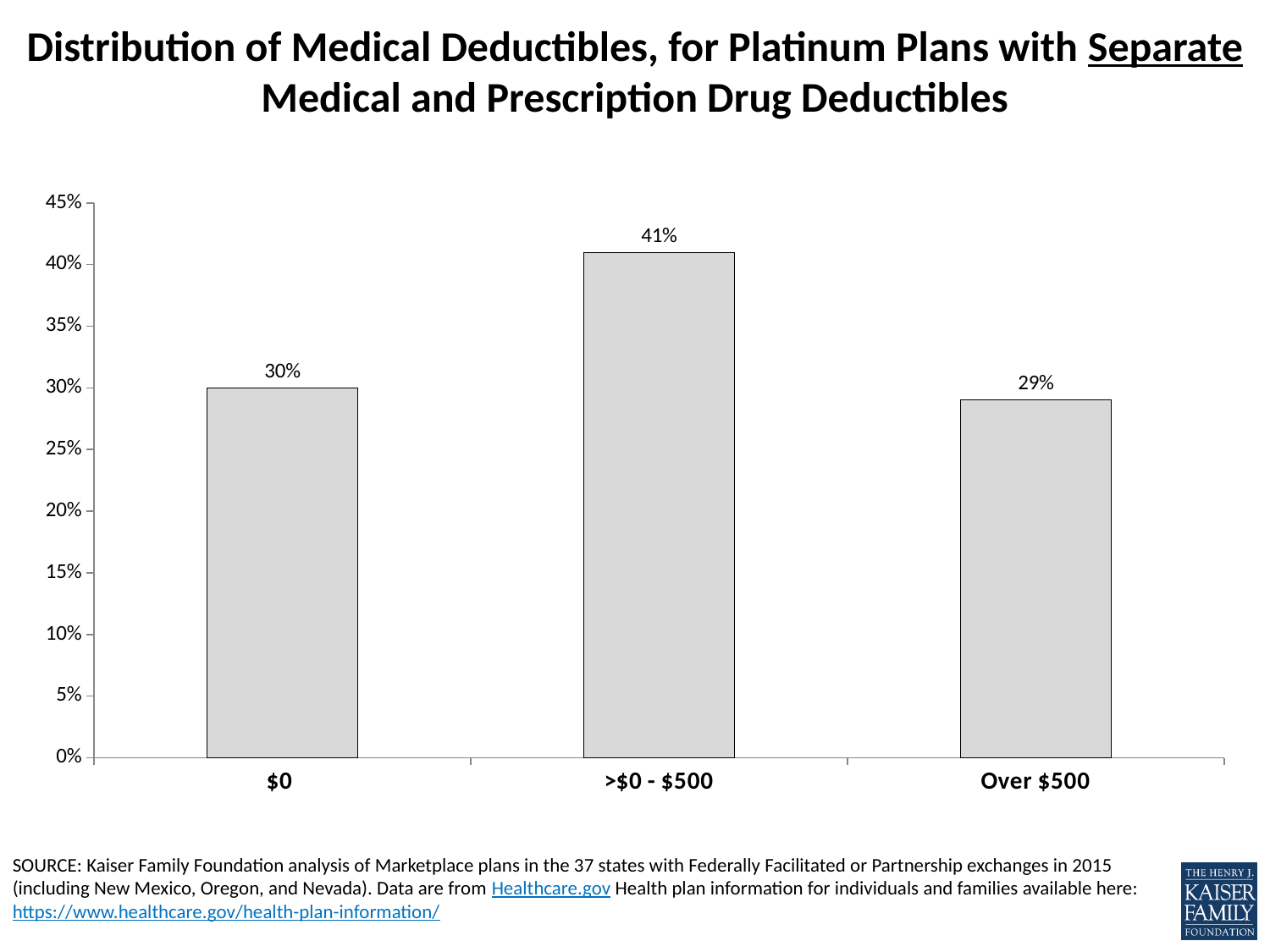
Which deductible category has the lowest share of plans? Over $500 What percentage of plans have a medical deductible of Over $500? 29% What is the maximum value shown on the vertical axis? 45% What is the title of the chart? Distribution of Medical Deductibles, for Platinum Plans with Separate Medical and Prescription Drug Deductibles Which is larger, the value for $0 or the value for Over $500? $0 What is the value shown for the >$0 - $500 category? 41% How many deductible categories are shown on the chart? 3 What is the difference in percentage points between the >$0 - $500 category and the $0 category? 11 What type of chart is shown on the slide? Bar chart What percentage of Platinum plans with separate deductibles have a $0 medical deductible? 30% Which deductible category has the highest share of plans? >$0 - $500 Is the value for >$0 - $500 greater or less than 40%? greater